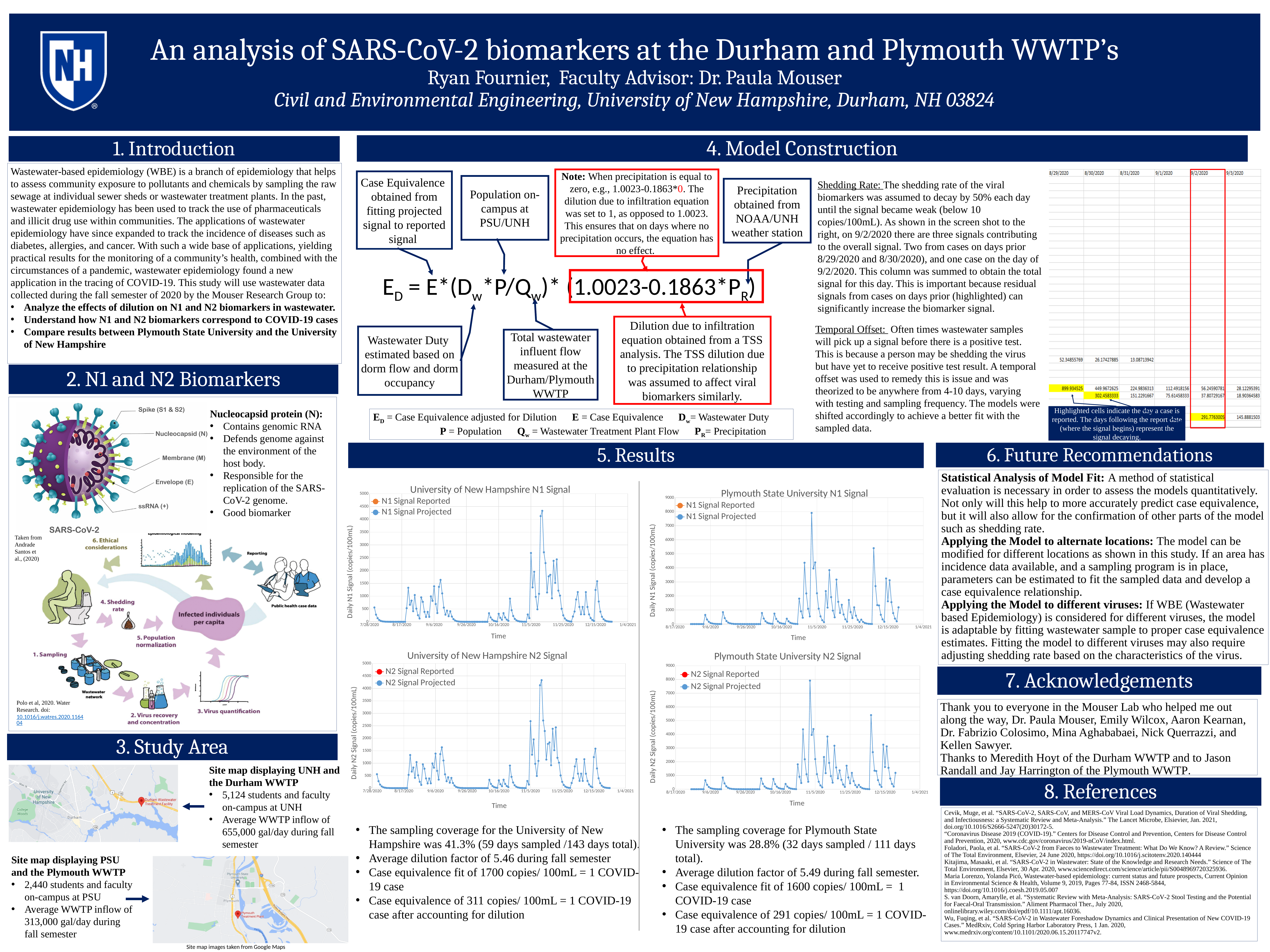
What colour is the 'N1 Signal Reported' series in the 'University of New Hampshire N1 Signal' chart legend? orange What are the two legend entries in the 'Plymouth State University N2 Signal' chart? N2 Signal Reported, N2 Signal Projected In the 'University of New Hampshire N1 Signal' chart, is the highest projected N1 signal value greater or less than 4000? greater In the 'University of New Hampshire N1 Signal' chart, is the projected N1 signal on 9/26/2020 greater or less than 500? less In the 'Plymouth State University N2 Signal' chart, is the highest projected N2 signal value greater or less than 7000? greater What kind of chart is the 'University of New Hampshire N1 Signal' chart? line chart How many charts are shown in the Results section of the slide? 4 How many series does the legend of the 'University of New Hampshire N1 Signal' chart list? 2 How many series does the legend of the 'Plymouth State University N2 Signal' chart list? 2